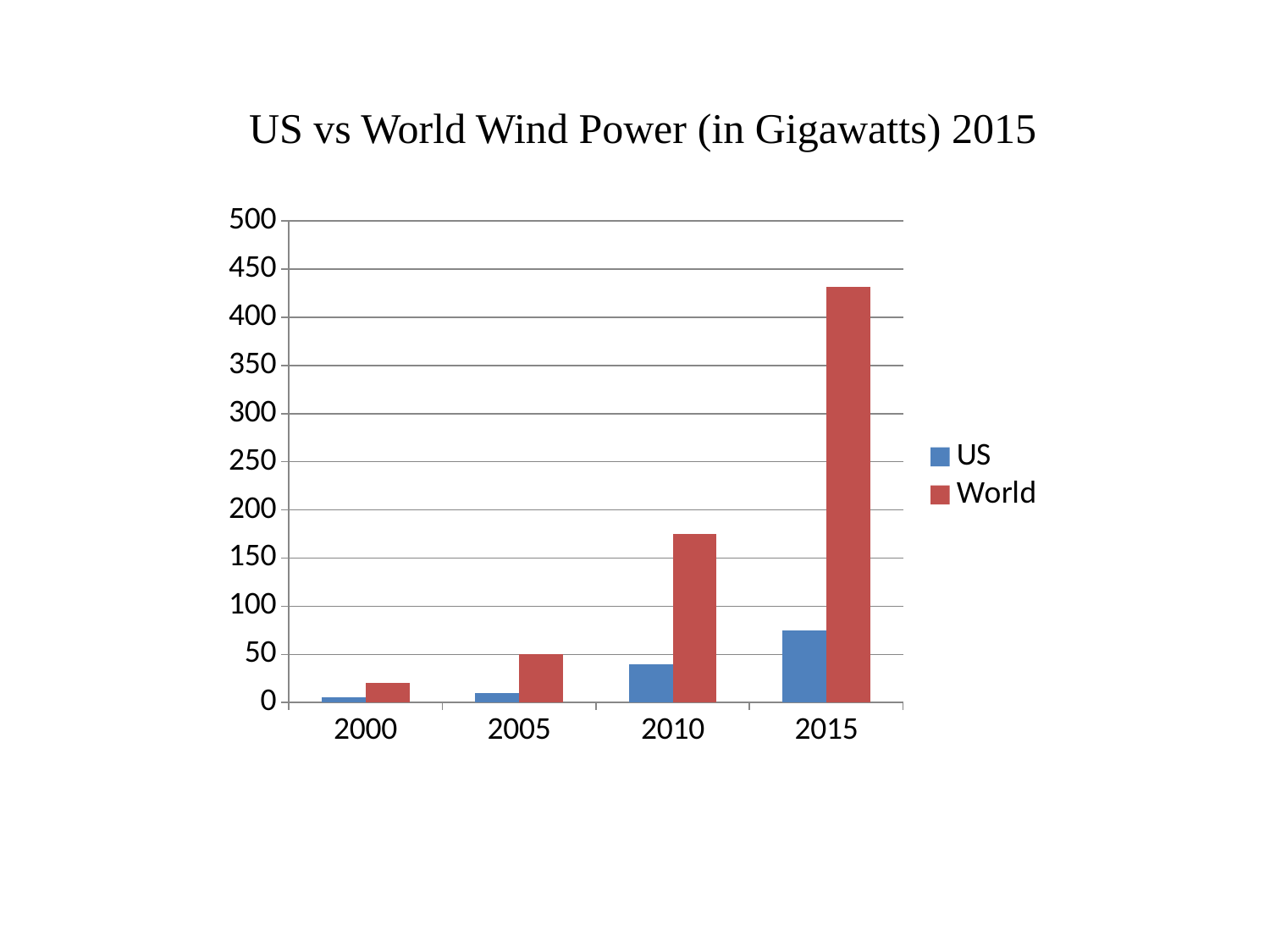
Which year has the highest World value? 2015 What kind of chart is shown on the slide? bar chart Is the US value for 2010 greater or less than 50? less Is the US value for 2015 greater or less than 100? less Do the World values rise or fall from 2000 to 2015? rise Which year has the lowest US value? 2000 How many series does the legend list? 2 Which is larger in 2010, the US value or the World value? World How many years are shown on the x axis? 4 Is the World value for 2010 greater or less than 150? greater What is the title of the chart? US vs World Wind Power (in Gigawatts) 2015